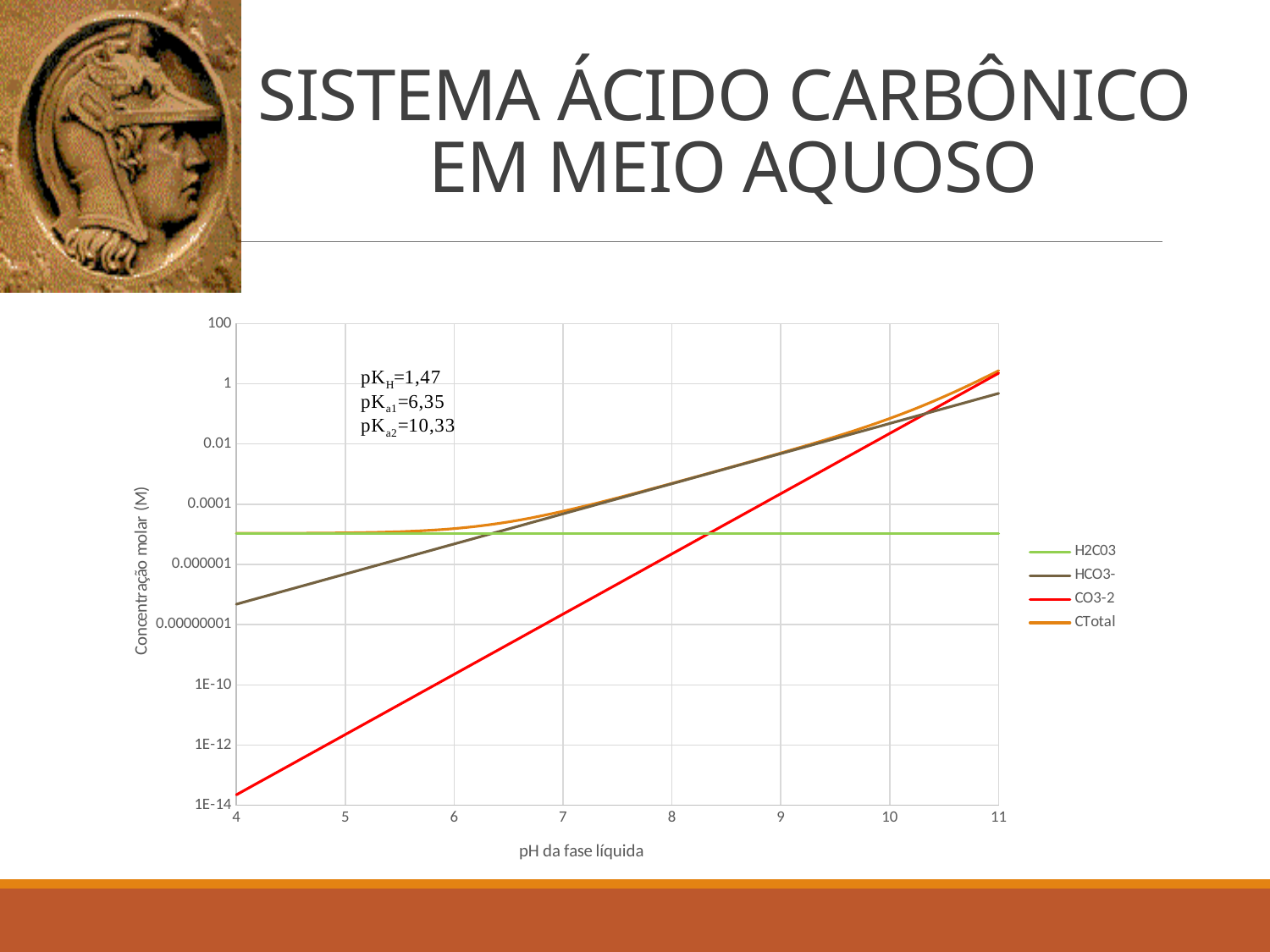
What kind of chart is shown on the slide? line chart At pH 5, which is larger, H2C03 or CO3-2? H2C03 What are the series names listed in the legend? H2C03, HCO3-, CO3-2, CTotal Does the CO3-2 series rise or fall as pH increases? rise How many pH tick values are labelled on the x axis? 8 Which series is lowest at pH 4? CO3-2 Is the value for HCO3- at pH 4 greater or less than 0.000001? less Is the value for H2C03 at pH 8 greater or less than 0.0001? less At pH 4, which is larger, HCO3- or CO3-2? HCO3- How many series does the legend list? 4 What is the title of the x axis? pH da fase líquida Is the value for CO3-2 at pH 5 greater or less than 1E-10? less